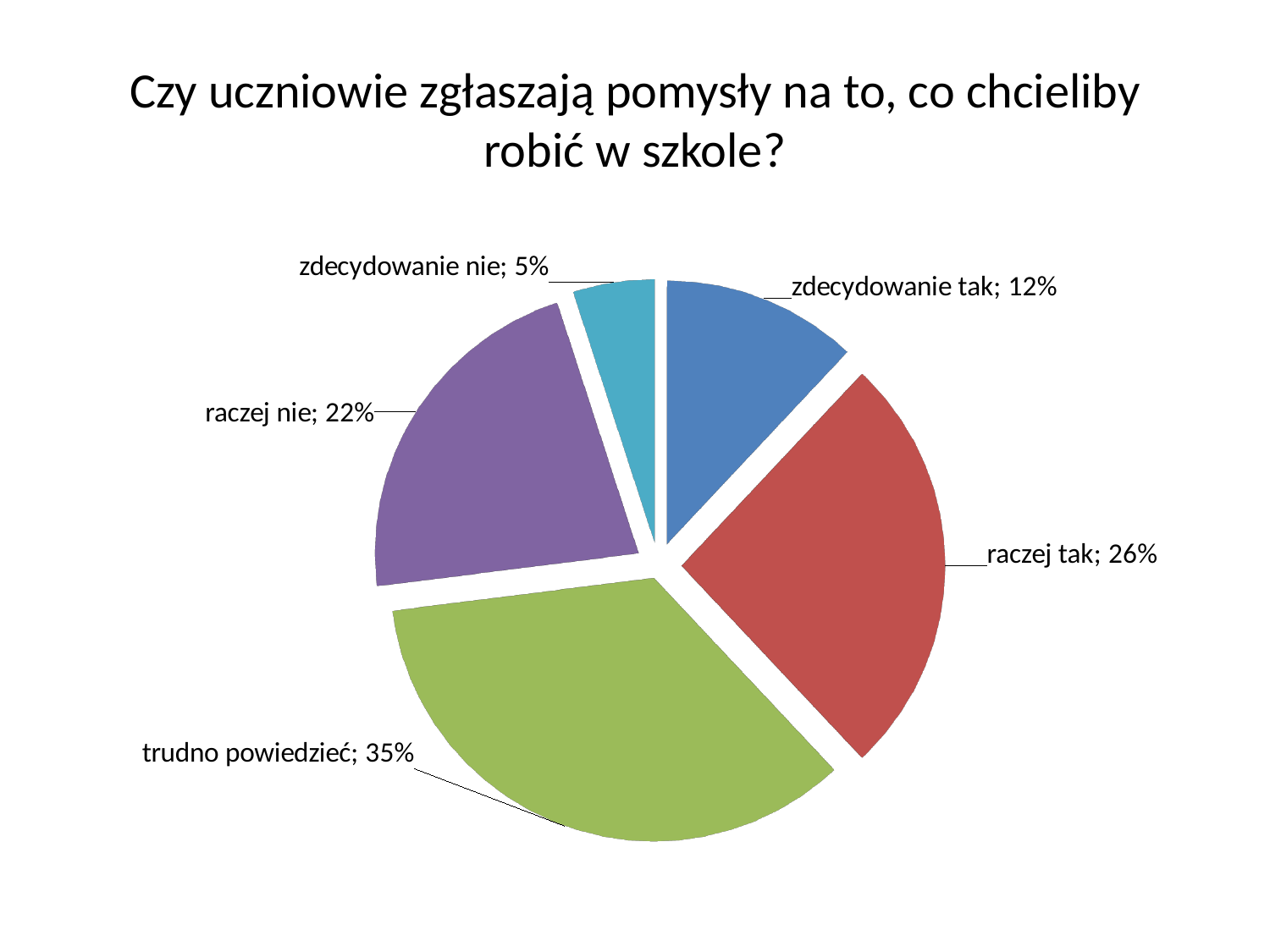
What kind of chart is shown on the slide? pie chart Which category has the smallest slice? zdecydowanie nie What share of the pie does "trudno powiedzieć" have? 35% Which category has the largest slice? trudno powiedzieć Which is larger, "raczej nie" or "zdecydowanie tak"? raczej nie What is the combined share of "zdecydowanie tak" and "raczej tak"? 38% How many slices does the pie chart have? 5 What is the difference between "raczej tak" and "zdecydowanie tak"? 14% What is the title of the chart? Czy uczniowie zgłaszają pomysły na to, co chcieliby robić w szkole? What is the value for "raczej nie"? 22% What is the value for "zdecydowanie nie"? 5% What is the value for "raczej tak"? 26%